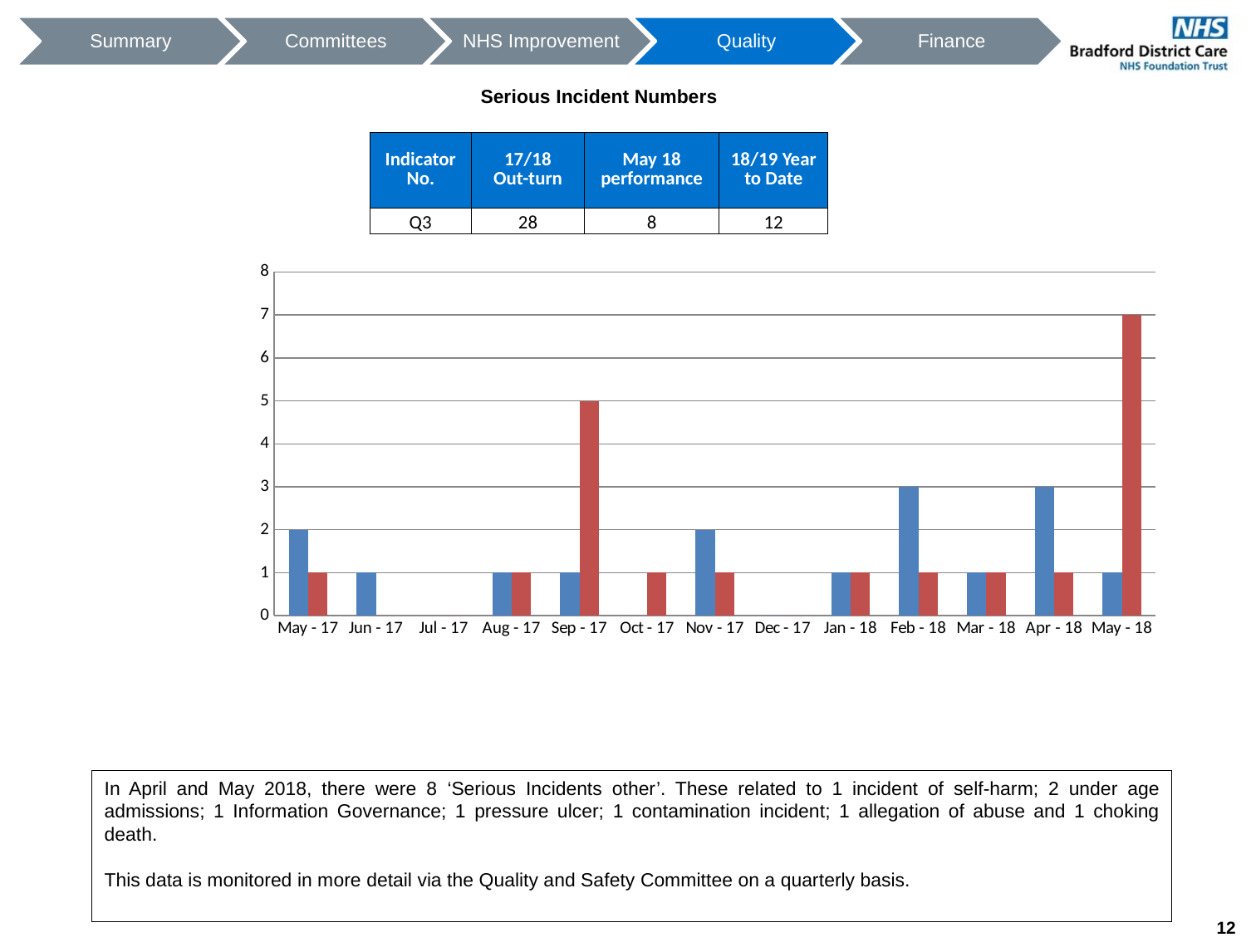
What is the title of the chart? Serious Incident Numbers In Sep - 17, which bar is larger, the blue bar or the red bar? The red bar Which months on the chart have no bars at all? Jul - 17 and Dec - 17 What is the value of the blue bar for May - 17? 2 What is the value of the red bar for May - 18? 7 In which month is the red bar highest? May - 18 In Apr - 18, which bar is larger, the blue bar or the red bar? The blue bar What is the value of the red bar for Sep - 17? 5 What is the value of the blue bar for Feb - 18? 3 What kind of chart is shown on the slide? Bar chart What is the difference between the red bar for May - 18 and the red bar for Sep - 17? 2 How many months are shown along the x axis of the chart? 13